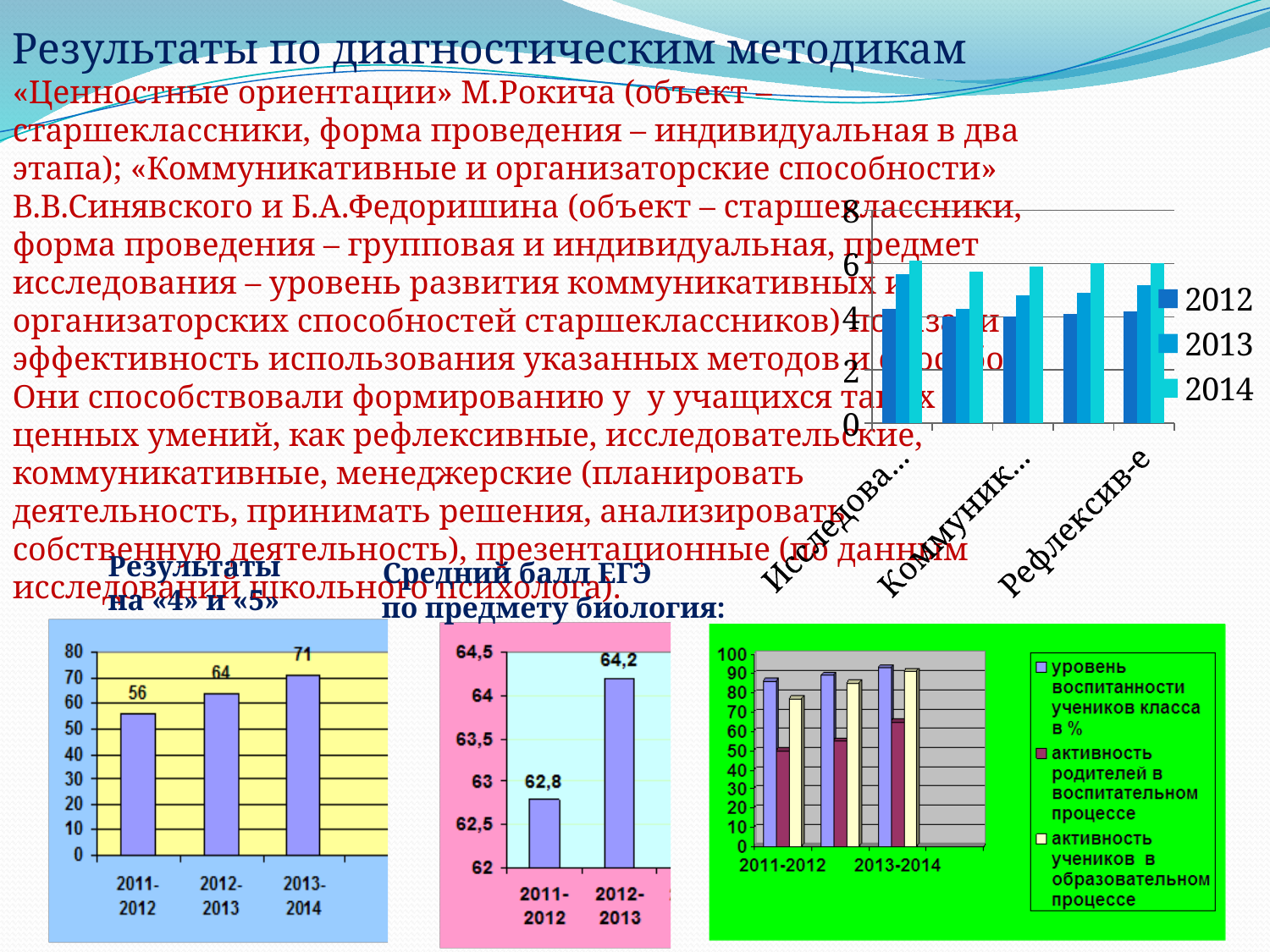
In the chart titled «Результаты на «4» и «5»», what is the value for 2011-2012? 56 In the chart titled «Результаты на «4» и «5»», do the values rise or fall from 2011-2012 to 2013-2014? rise In the chart titled «Результаты на «4» и «5»», what is the difference between the 2013-2014 and 2011-2012 values? 15 In the chart titled «Средний балл ЕГЭ по предмету биология», what is the value for 2012-2013? 64,2 In the chart titled «Результаты на «4» и «5»», what is the value for 2013-2014? 71 In the chart titled «Результаты на «4» и «5»», which year has the highest value? 2013-2014 In the top-right chart, how many series does the legend list? 3 In the bottom-right chart with the green background, is the value of «активность родителей в воспитательном процессе» for 2011-2012 greater or less than 60? less In the chart titled «Результаты на «4» и «5»», how many bars are plotted? 3 What kind of chart is the chart titled «Средний балл ЕГЭ по предмету биология»? bar chart In the chart titled «Средний балл ЕГЭ по предмету биология», which year has the lower value? 2011-2012 In the chart titled «Средний балл ЕГЭ по предмету биология», what is the value for 2011-2012? 62,8